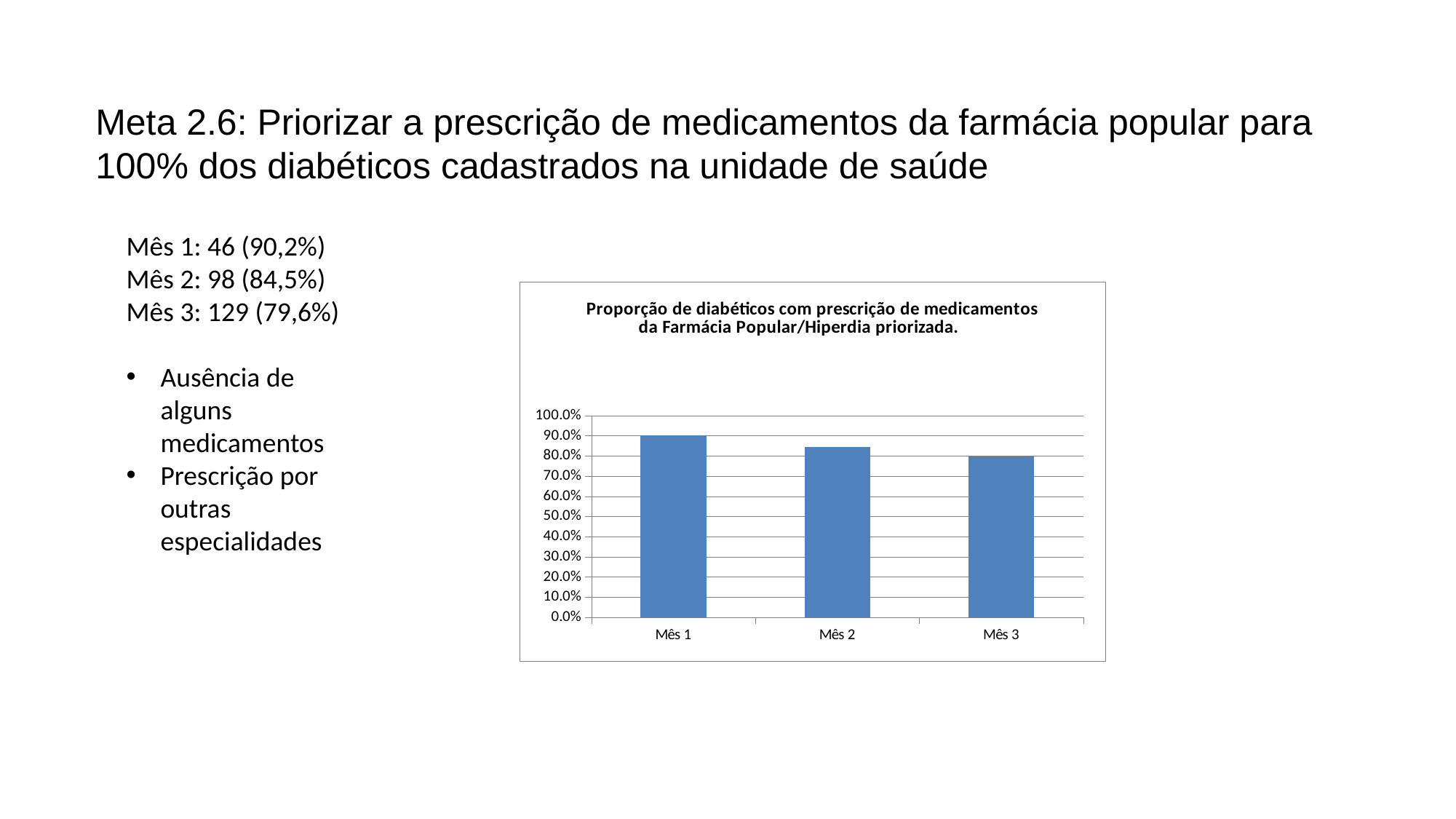
Is the value for Mês 1 greater or less than 80.0%? greater Do the values rise or fall from Mês 1 to Mês 3? fall What kind of chart is shown on the slide? bar chart Is the value for Mês 2 greater or less than 90.0%? less Which is larger, the value for Mês 1 or the value for Mês 3? Mês 1 What is the highest value shown on the chart's vertical axis? 100.0% How many categories (months) are plotted on the chart? 3 Is the value for Mês 3 greater or less than 70.0%? greater Which month has the lowest proportion in the chart? Mês 3 What is the title of the chart? Proporção de diabéticos com prescrição de medicamentos da Farmácia Popular/Hiperdia priorizada. Which month has the highest proportion in the chart? Mês 1